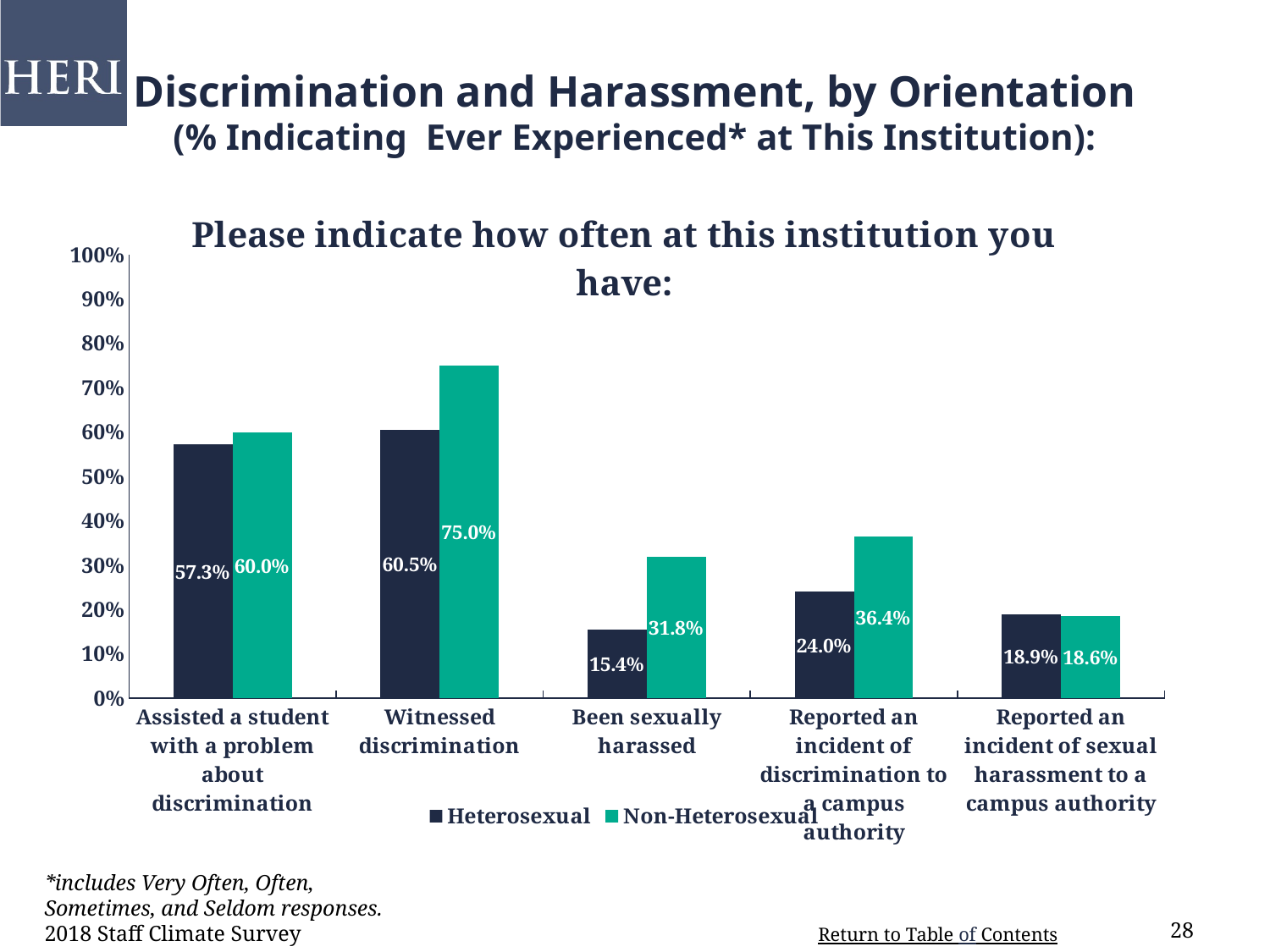
What kind of chart is shown on the slide? Bar chart How many categories are shown on the x axis? 5 What is the Heterosexual value for 'Reported an incident of discrimination to a campus authority'? 24.0% What is the difference between the Non-Heterosexual and Heterosexual values for 'Been sexually harassed'? 16.4% How many series does the legend list? 2 What is the Heterosexual value for 'Been sexually harassed'? 15.4% Which category has the highest Non-Heterosexual value? Witnessed discrimination Which category has the lowest Heterosexual value? Been sexually harassed Is the Heterosexual value for 'Assisted a student with a problem about discrimination' greater or less than 50%? greater What is the Non-Heterosexual value for 'Witnessed discrimination'? 75.0% For 'Reported an incident of discrimination to a campus authority', which group has the larger value, Heterosexual or Non-Heterosexual? Non-Heterosexual What is the difference between the Non-Heterosexual and Heterosexual values for 'Witnessed discrimination'? 14.5%